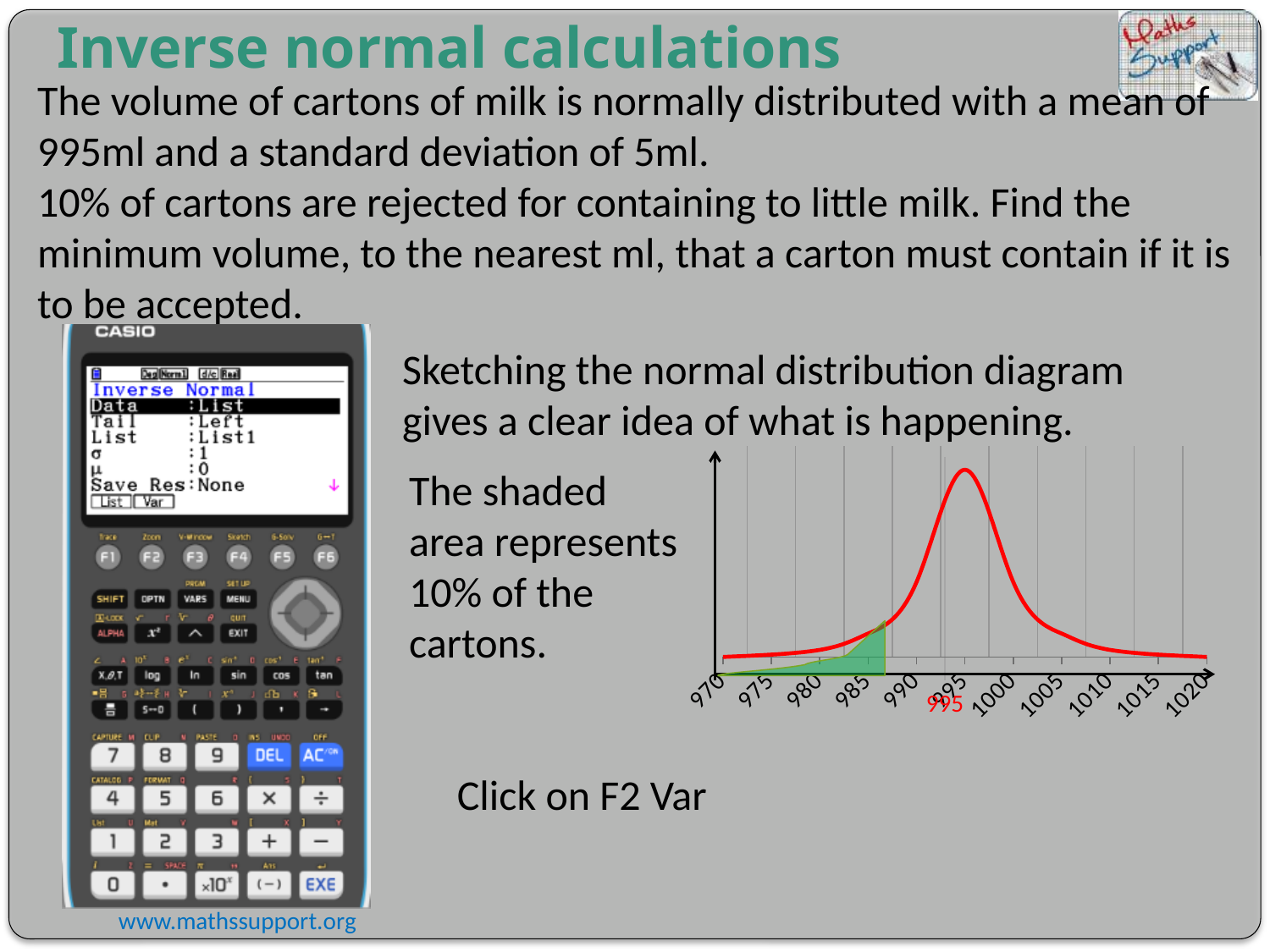
What is the lowest value labelled on the x axis of the chart? 970 What percentage of the cartons does the shaded area of the chart represent? 10% At which x-axis value does the red curve reach its peak? 995 What is the highest value labelled on the x axis of the chart? 1020 What kind of chart is shown on the right of the slide? line chart How many labelled tick values are shown on the x axis of the normal distribution chart? 11 On which side of the peak is the shaded area located? left What colour is the shaded area under the curve? green Does the curve rise or fall as x increases from 995 to 1020? fall Is the curve higher at 995 or at 980? 995 Does the curve rise or fall as x increases from 970 to 995? rise Is the curve higher at 1000 or at 1015? 1000